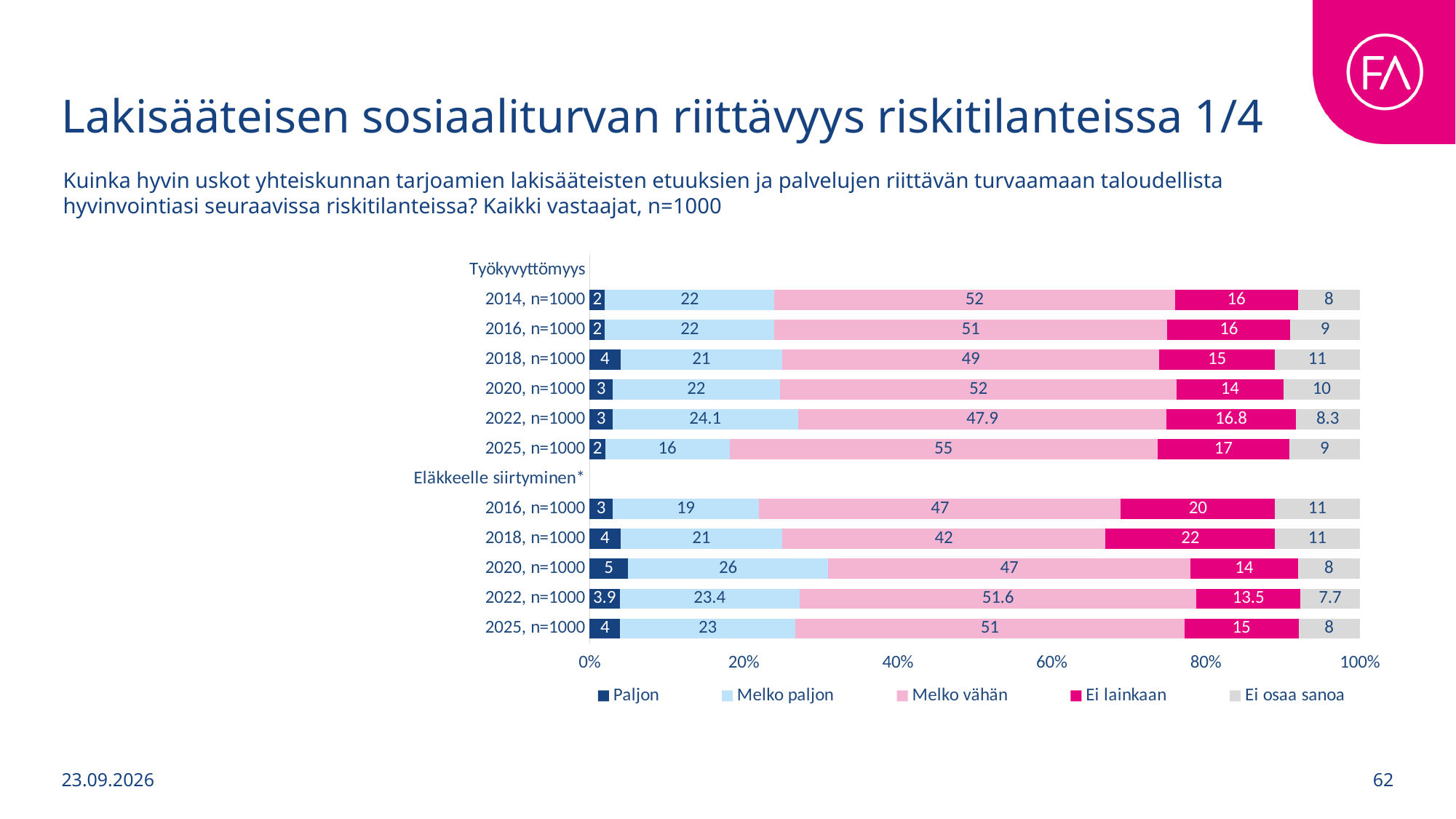
What kind of chart is shown on the slide? Stacked bar chart How many bars are shown under the Eläkkeelle siirtyminen group? 5 What is the difference between the "Ei lainkaan" values for Eläkkeelle siirtyminen 2018 and 2020? 8 What is the value of "Paljon" for Eläkkeelle siirtyminen 2022, n=1000? 3.9 How many series does the legend list? 5 Among the Eläkkeelle siirtyminen bars, which year has the highest "Paljon" value? 2020, n=1000 Which is larger: "Melko vähän" for Työkyvyttömyys 2014 or for Eläkkeelle siirtyminen 2018? Työkyvyttömyys 2014 Among the Työkyvyttömyys bars, which year has the lowest "Melko paljon" value? 2025, n=1000 What is the total of the Työkyvyttömyys 2022, n=1000 bar? 100.1 What is the value of "Melko vähän" for Työkyvyttömyys 2025, n=1000? 55 What is the value of "Melko paljon" for Työkyvyttömyys 2022, n=1000? 24.1 What is the value of "Ei lainkaan" for Eläkkeelle siirtyminen 2018, n=1000? 22